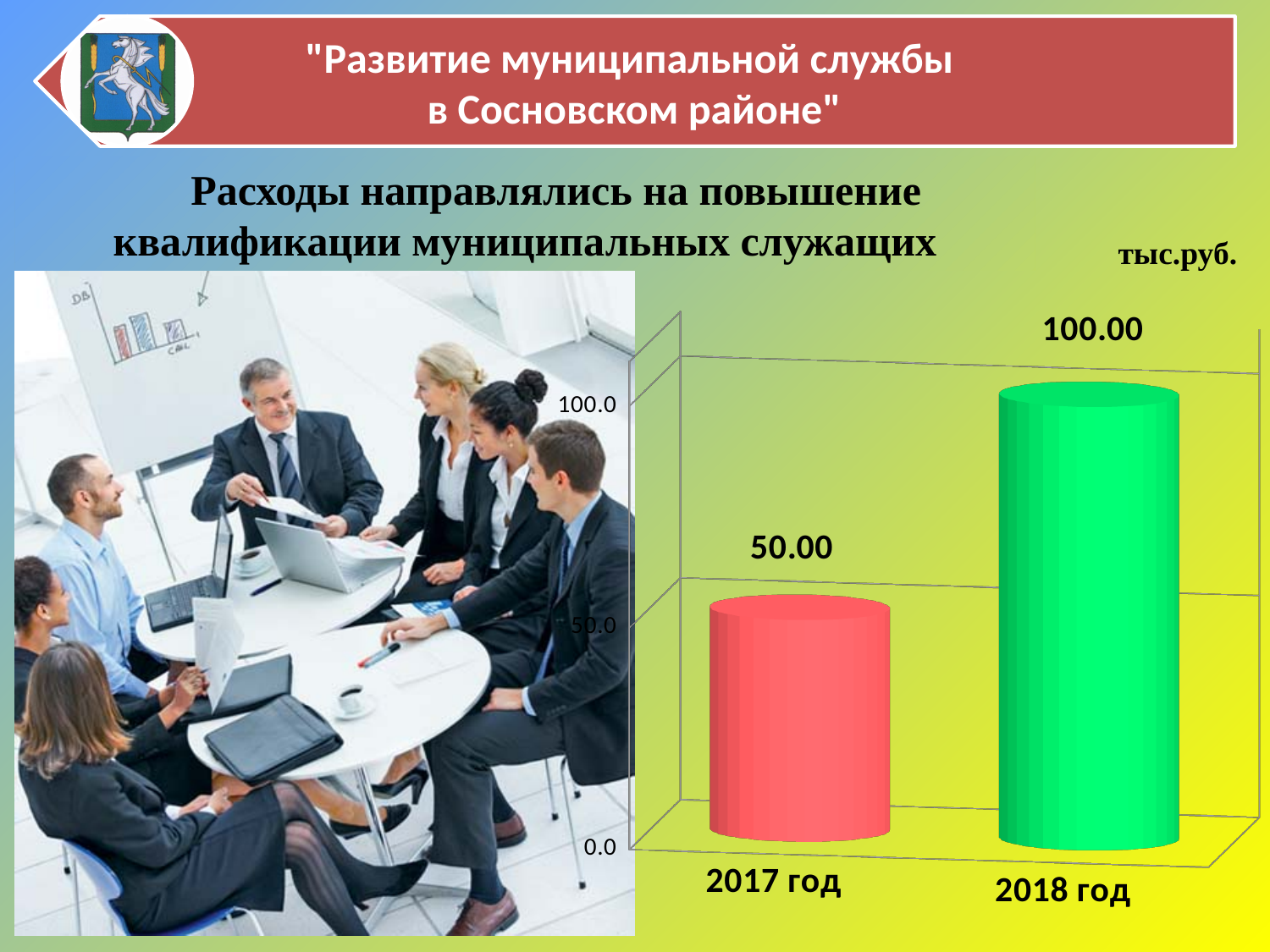
What is the difference between the values for 2018 год and 2017 год? 50.00 What unit is indicated for the chart values? тыс.руб. How many categories are shown on the chart? 2 What is the value for 2018 год? 100.00 Which is larger, the value for 2017 год or the value for 2018 год? 2018 год What colour is the bar for 2018 год? green What kind of chart is shown on the slide? bar chart Which year has the lowest value? 2017 год What is the value for 2017 год? 50.00 Do the values rise or fall from 2017 год to 2018 год? rise Which year has the highest value? 2018 год